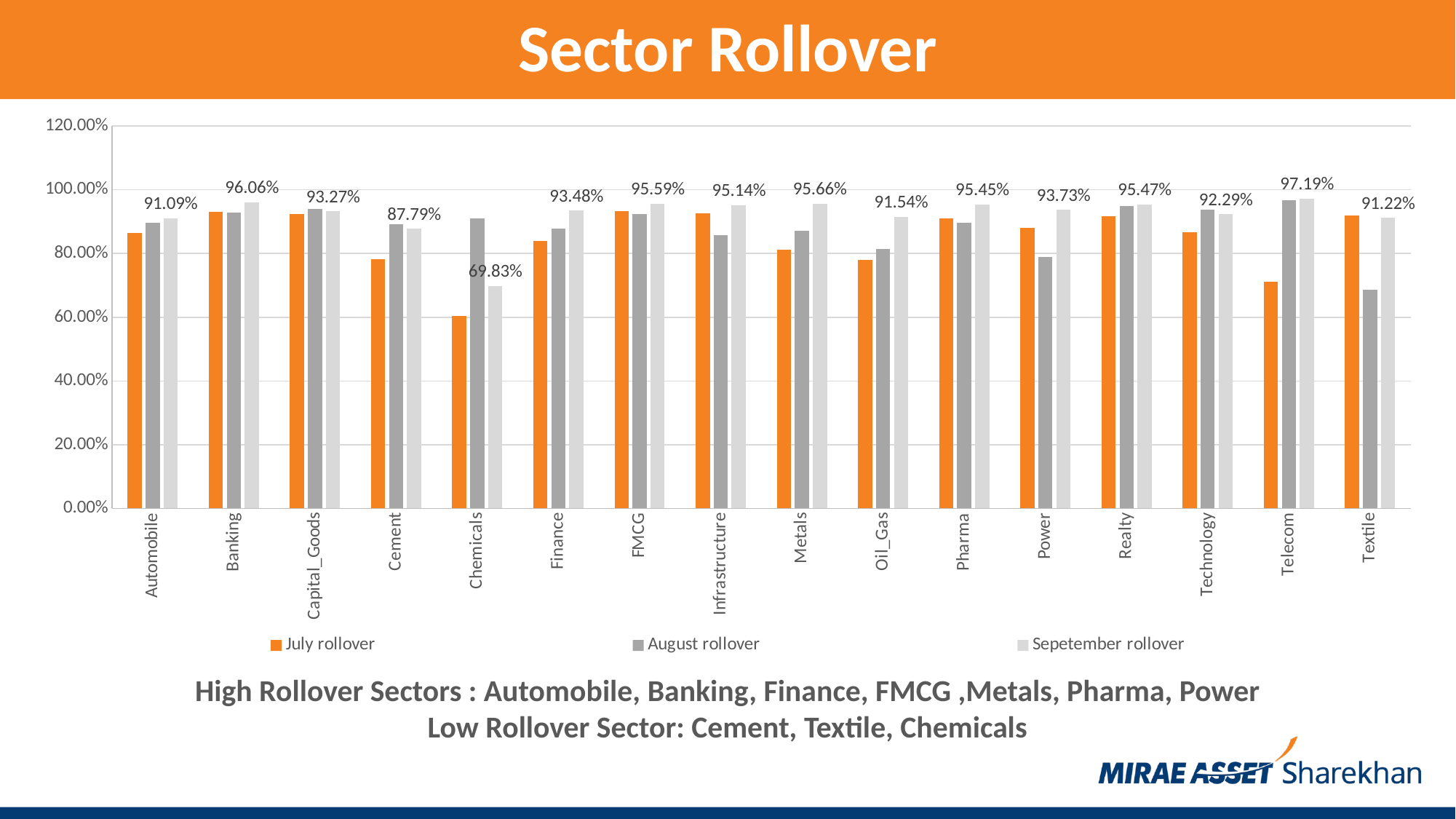
Which sector has the lowest September rollover? Chemicals Which sector has the highest September rollover? Telecom How many sectors are shown on the x axis? 16 What is the September rollover value for Telecom? 97.19% What is the difference between the September rollover for Banking and for Automobile? 4.97% How many series does the legend list? 3 Is the July rollover value for Cement greater or less than 80.00%? less Which is larger, the September rollover for FMCG or for Technology? FMCG What is the September rollover value for Chemicals? 69.83% What kind of chart is shown on the slide? Bar chart What is the September rollover value for Cement? 87.79% Is the August rollover value for Textile greater or less than 80.00%? less